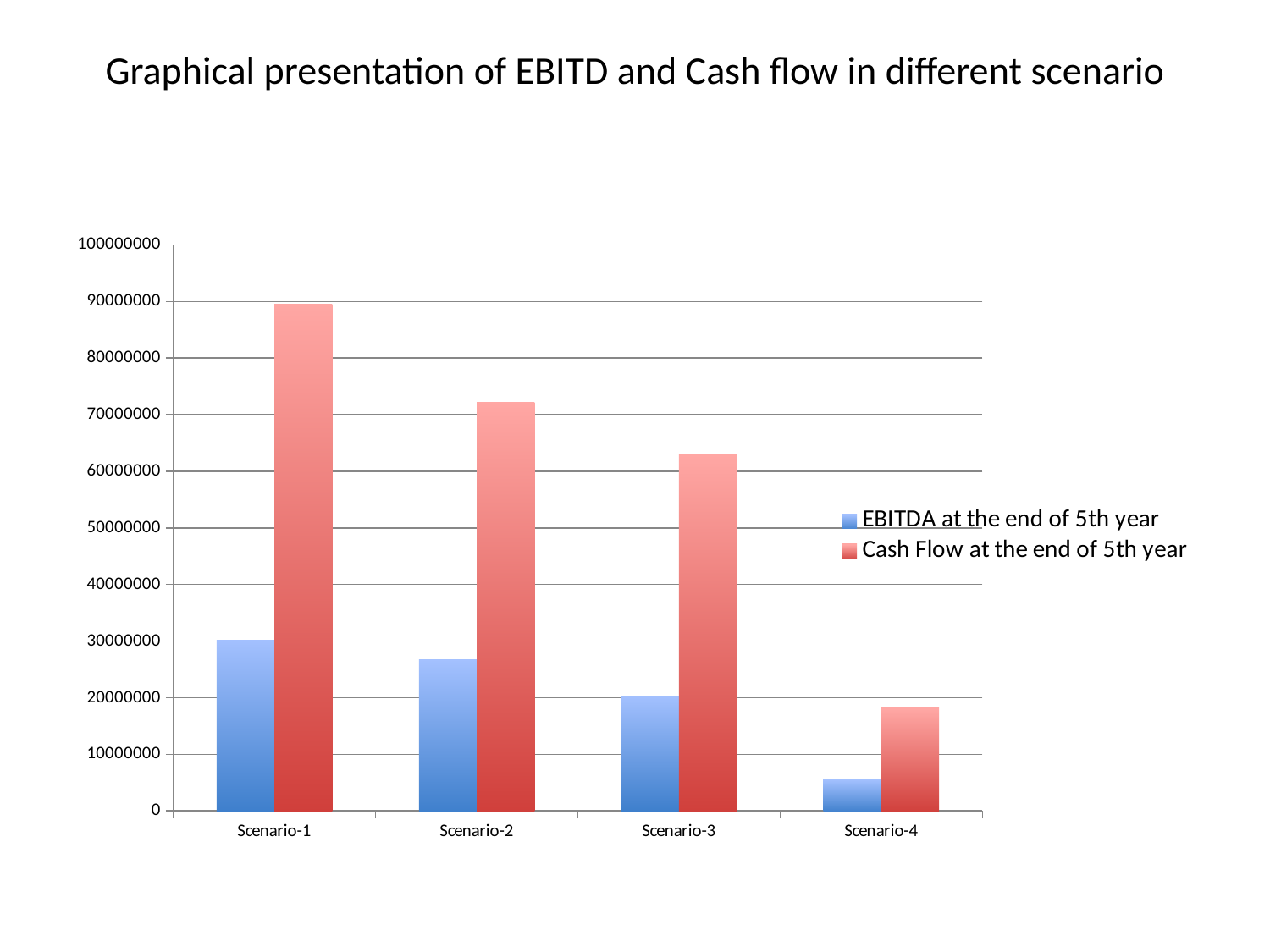
Is the Cash Flow at the end of 5th year for Scenario-3 greater or less than 60000000? greater What kind of chart is shown on the slide? bar chart Which scenario has the highest Cash Flow at the end of 5th year? Scenario-1 How many series does the legend list? 2 Which scenario has the lowest EBITDA at the end of 5th year? Scenario-4 Is the EBITDA at the end of 5th year for Scenario-4 greater or less than 10000000? less How many scenarios are shown on the x axis? 4 Is the Cash Flow at the end of 5th year for Scenario-1 greater or less than 80000000? greater Which scenario has the lowest Cash Flow at the end of 5th year? Scenario-4 Do the Cash Flow at the end of 5th year values rise or fall from Scenario-1 to Scenario-4? fall What is the title of the slide? Graphical presentation of EBITD and Cash flow in different scenario Which is larger for Scenario-2: EBITDA at the end of 5th year or Cash Flow at the end of 5th year? Cash Flow at the end of 5th year